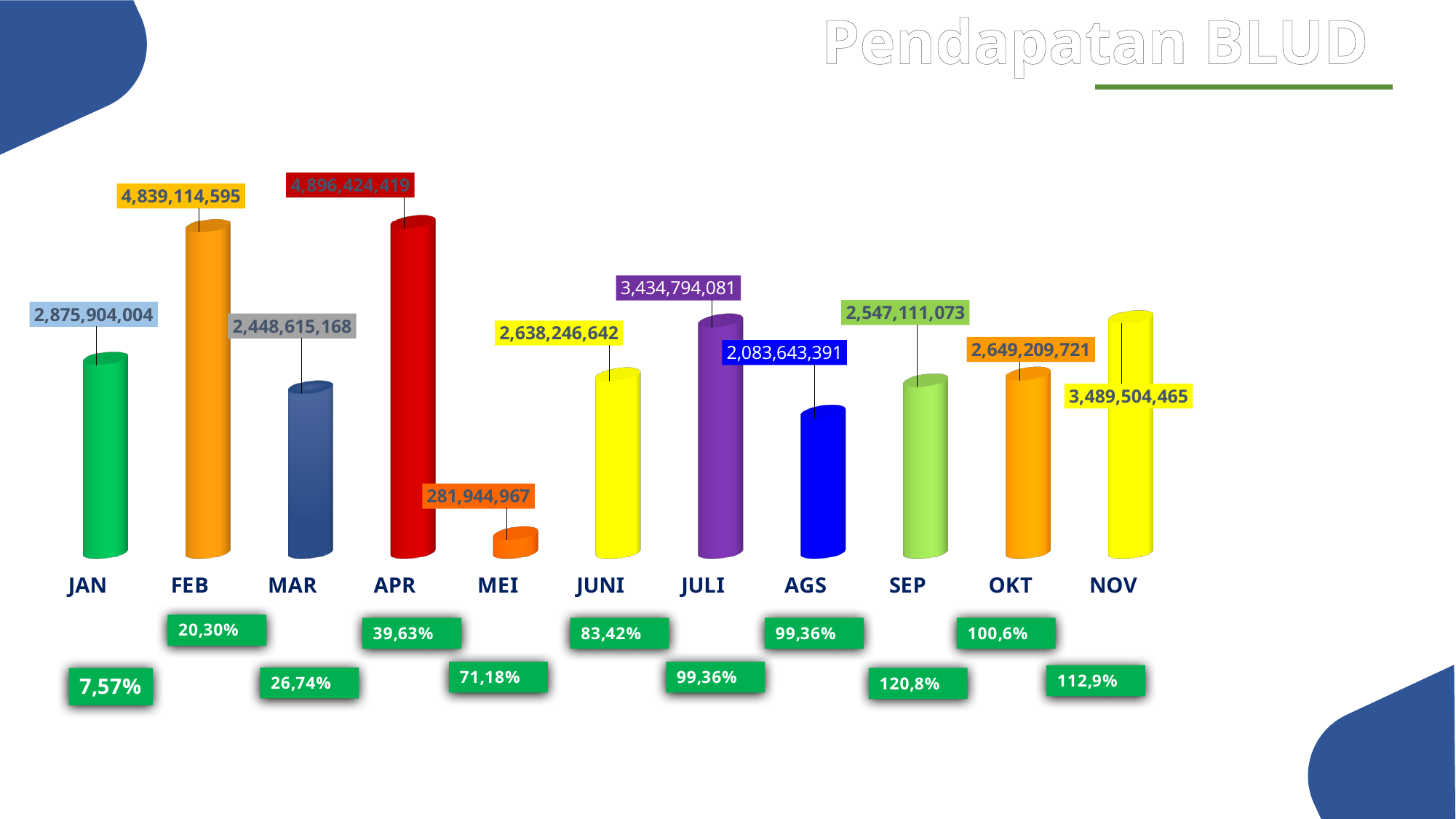
What is the difference between the values for APR and FEB? 57,309,824 What kind of chart is shown on the slide? Bar chart What is the value for AGS? 2,083,643,391 Which month has the lowest value? MEI What is the value for NOV? 3,489,504,465 What is the value for FEB? 4,839,114,595 Which month has the highest value? APR What is the difference between the values for JAN and MAR? 427,288,836 Which is larger, the value for JULI or the value for AGS? JULI What is the title of the chart? Pendapatan BLUD What is the value for MEI? 281,944,967 How many months are shown on the chart? 11